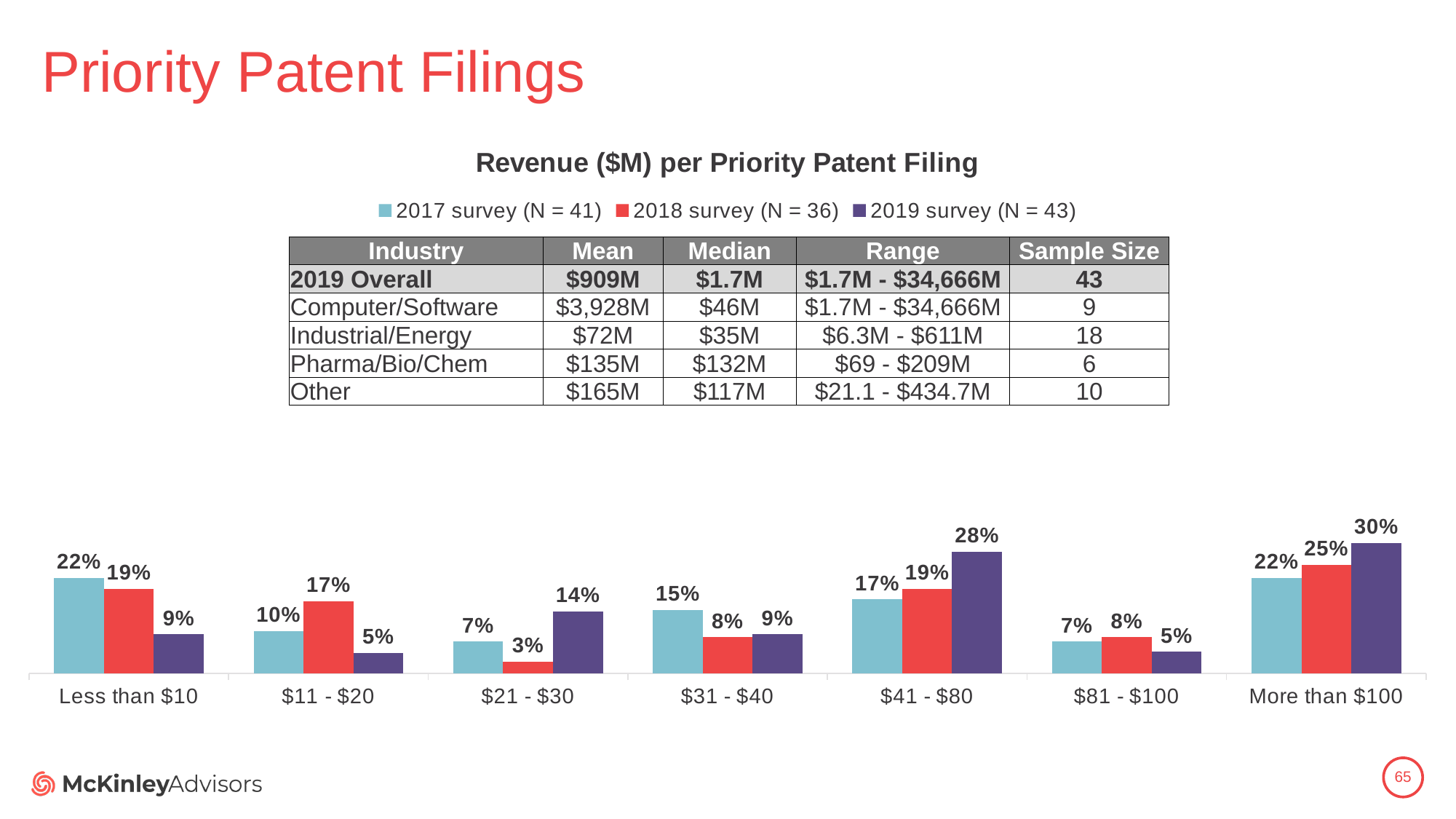
What is the title of the chart? Revenue ($M) per Priority Patent Filing Which is larger in the 'Less than $10' category: the 2017 survey value or the 2019 survey value? 2017 survey How many series does the chart legend list? 3 What kind of chart is shown on the slide? Bar chart Which category has the highest value for the 2019 survey? More than $100 How many revenue categories are shown on the x axis of the chart? 7 What is the value for the 2017 survey in the '$31 - $40' category? 15% What is the value for the 2019 survey in the 'More than $100' category? 30% What is the sample size (N) for the 2018 survey shown in the legend? 36 What is the difference between the 2019 survey and 2017 survey values in the '$41 - $80' category? 11% What is the value for the 2018 survey in the '$21 - $30' category? 3% Which category has the lowest value for the 2018 survey? $21 - $30